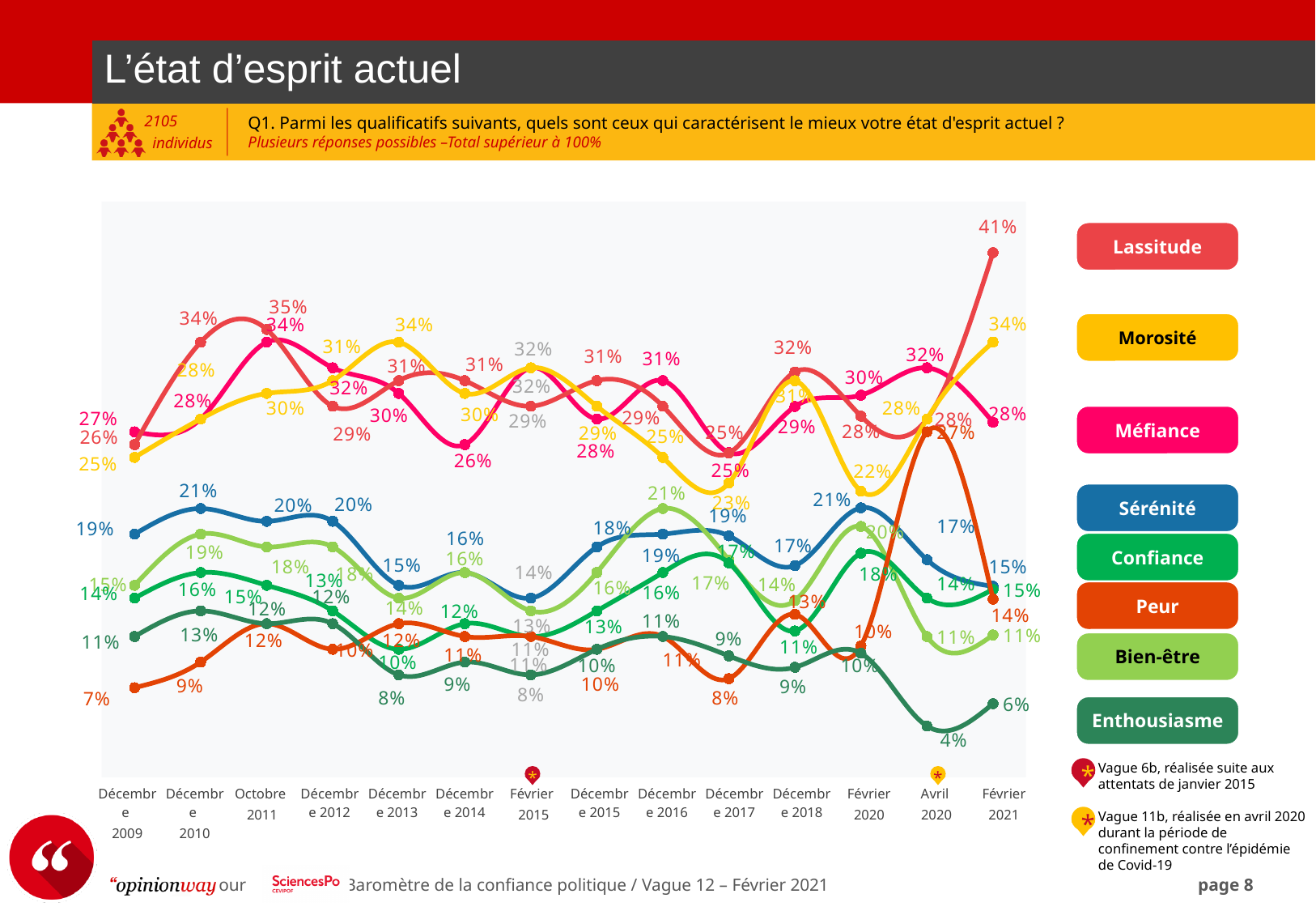
Does the Lassitude line rise or fall between Avril 2020 and Février 2021? rise Which series has the lowest value in Février 2021? Enthousiasme What is the value for Enthousiasme in Avril 2020? 4% What kind of chart is shown on the slide? line chart What is the value for Morosité in Février 2021? 34% How many time points are shown on the x axis? 14 How many series does the legend list? 8 What is the value for Lassitude in Février 2021? 41% In Février 2021, which is larger: Lassitude or Méfiance? Lassitude What is the value for Peur in Décembre 2009? 7% What is the difference between Lassitude and Morosité in Février 2021? 7 percentage points Which series has the highest value in Février 2021? Lassitude